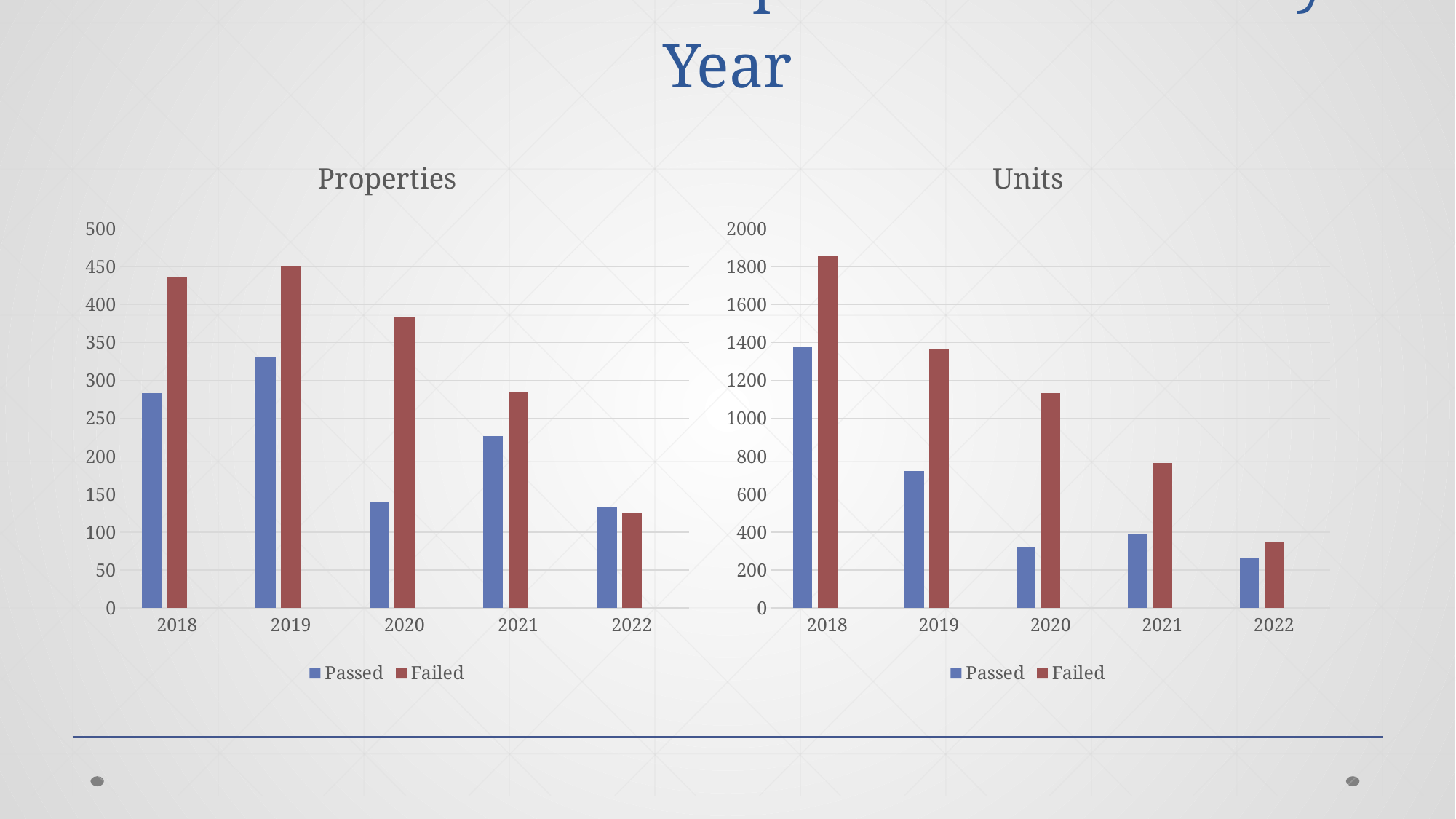
In the Units chart, which is larger for 2021, Passed or Failed? Failed In the Units chart, is the Passed value for 2018 greater or less than 1200? greater In the Units chart, which year has the lowest Passed value? 2022 In the Units chart, which year has the highest Failed value? 2018 In the Properties chart, is the Passed value for 2019 greater or less than 300? greater How many years are shown on the x axis of the Properties chart? 5 In the Units chart, is the Failed value for 2022 greater or less than 400? less In the Properties chart, which year has the lowest Failed value? 2022 In the Properties chart, which year has the highest Passed value? 2019 How many series does the legend of the Units chart list? 2 In the Units chart, do the Failed values rise or fall from 2018 to 2022? fall